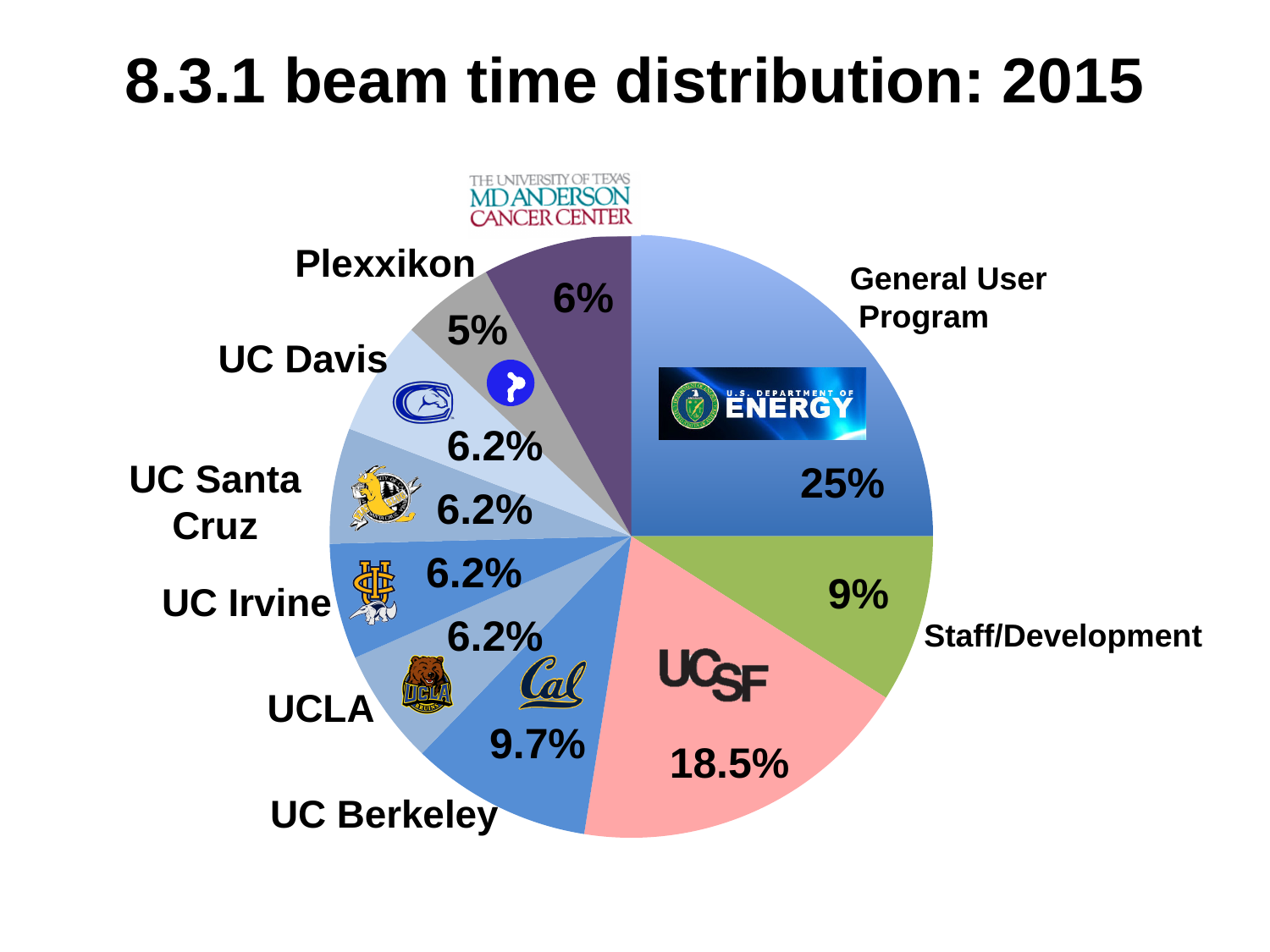
What is the title of the slide? 8.3.1 beam time distribution: 2015 How many slices does the pie chart have? 10 What share of beam time went to Staff/Development? 9% What share of beam time went to the General User Program? 25% Which category has the largest share of beam time? General User Program What share of beam time went to Plexxikon? 5% Which category has the smallest share of beam time? Plexxikon What kind of chart is shown on the slide? pie chart What is the difference between the General User Program share and the Staff/Development share? 16% Which has a larger share of beam time, UC Berkeley or Staff/Development? UC Berkeley What share of beam time went to UC Berkeley? 9.7% What share of beam time went to UC Davis? 6.2%